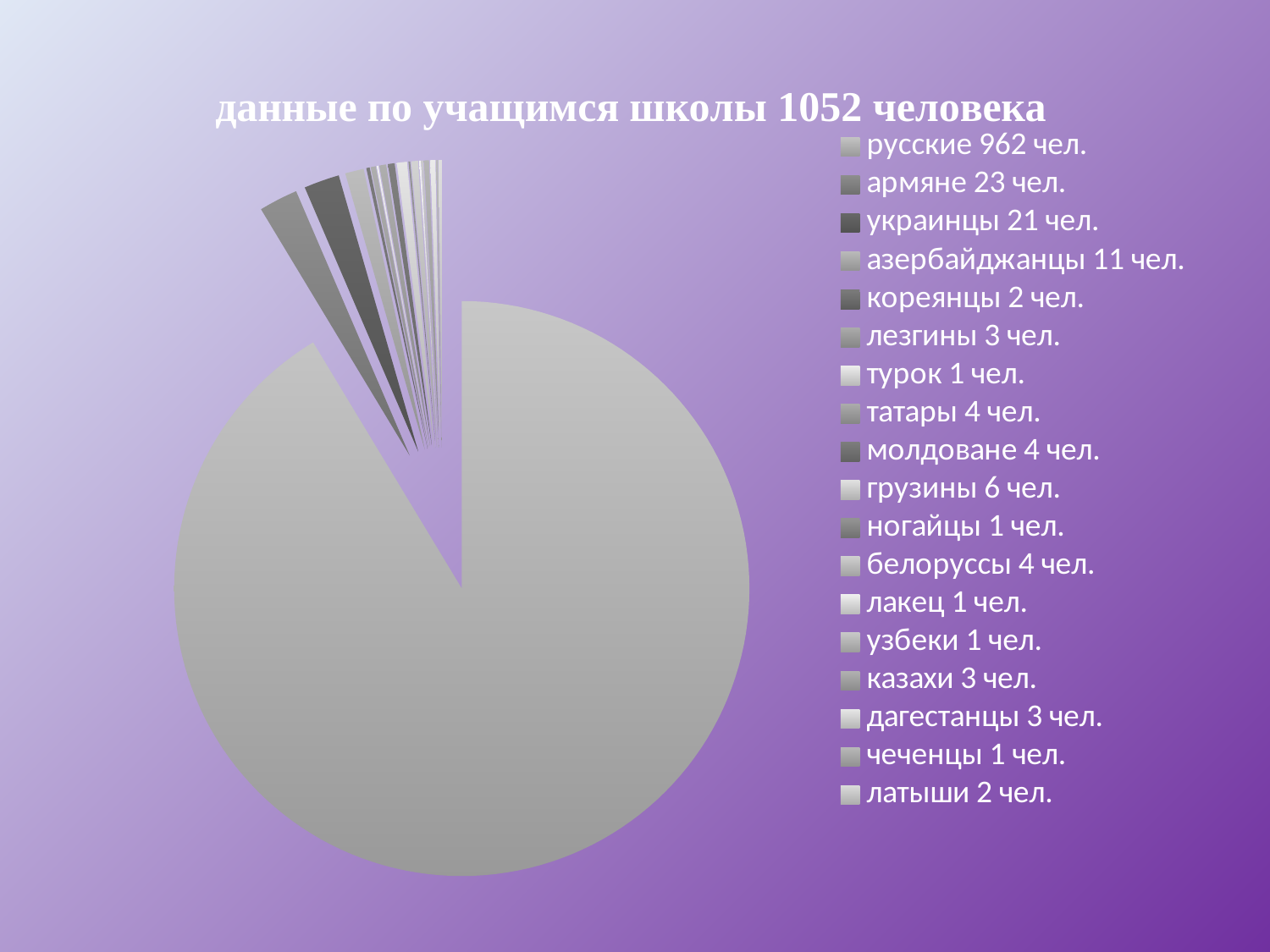
What is the difference between the number of армяне and the number of украинцы? 2 What kind of chart is shown on the slide? pie chart How many people are listed for грузины? 6 чел. What is the difference between the number of русские and the number of армяне? 939 Which category has the largest slice of the pie? русские How many categories does the legend list? 18 How many people are listed for латыши? 2 чел. What is the title of the chart? данные по учащимся школы 1052 человека How many people are listed for азербайджанцы? 11 чел. How many people are listed for армяне? 23 чел. How many people are listed for русские? 962 чел. Which is larger, the value for украинцы or the value for азербайджанцы? украинцы